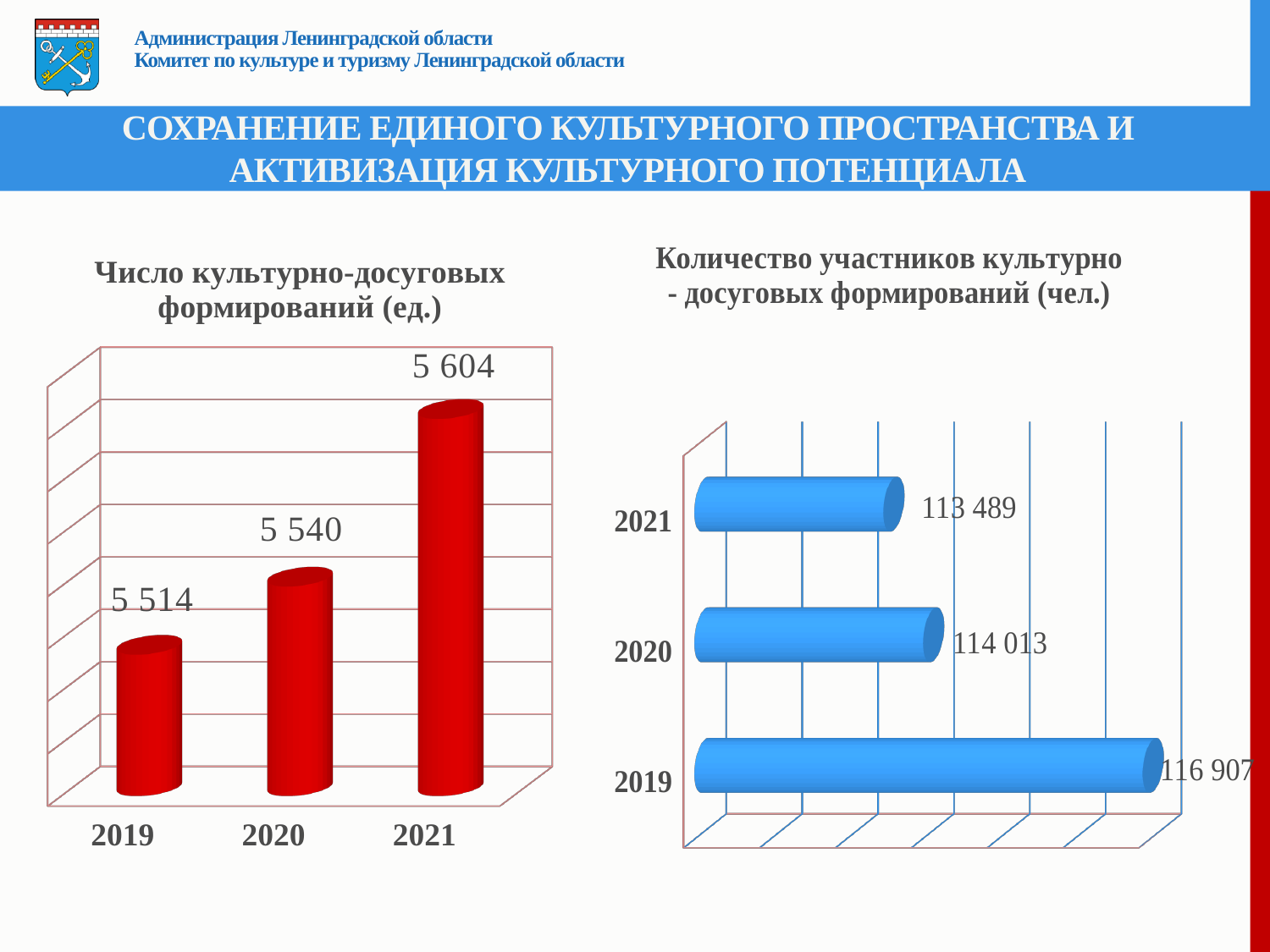
In the chart 'Число культурно-досуговых формирований (ед.)', which year has the highest value? 2021 In the chart 'Число культурно-досуговых формирований (ед.)', do the values rise or fall from 2019 to 2021? rise In the chart 'Количество участников культурно-досуговых формирований (чел.)', what is the difference between the 2019 and 2021 values? 3 418 In the chart 'Число культурно-досуговых формирований (ед.)', what is the value for 2019? 5 514 In the chart 'Число культурно-досуговых формирований (ед.)', how many years are shown? 3 In the chart 'Число культурно-досуговых формирований (ед.)', what is the difference between the 2021 and 2019 values? 90 In the chart 'Количество участников культурно-досуговых формирований (чел.)', which is larger, the value for 2020 or the value for 2021? 2020 What kind of chart is the chart 'Количество участников культурно-досуговых формирований (чел.)'? bar chart In the chart 'Количество участников культурно-досуговых формирований (чел.)', which year has the lowest value? 2021 In the chart 'Число культурно-досуговых формирований (ед.)', what is the value for 2021? 5 604 In the chart 'Количество участников культурно-досуговых формирований (чел.)', what is the value for 2021? 113 489 In the chart 'Количество участников культурно-досуговых формирований (чел.)', what is the value for 2019? 116 907